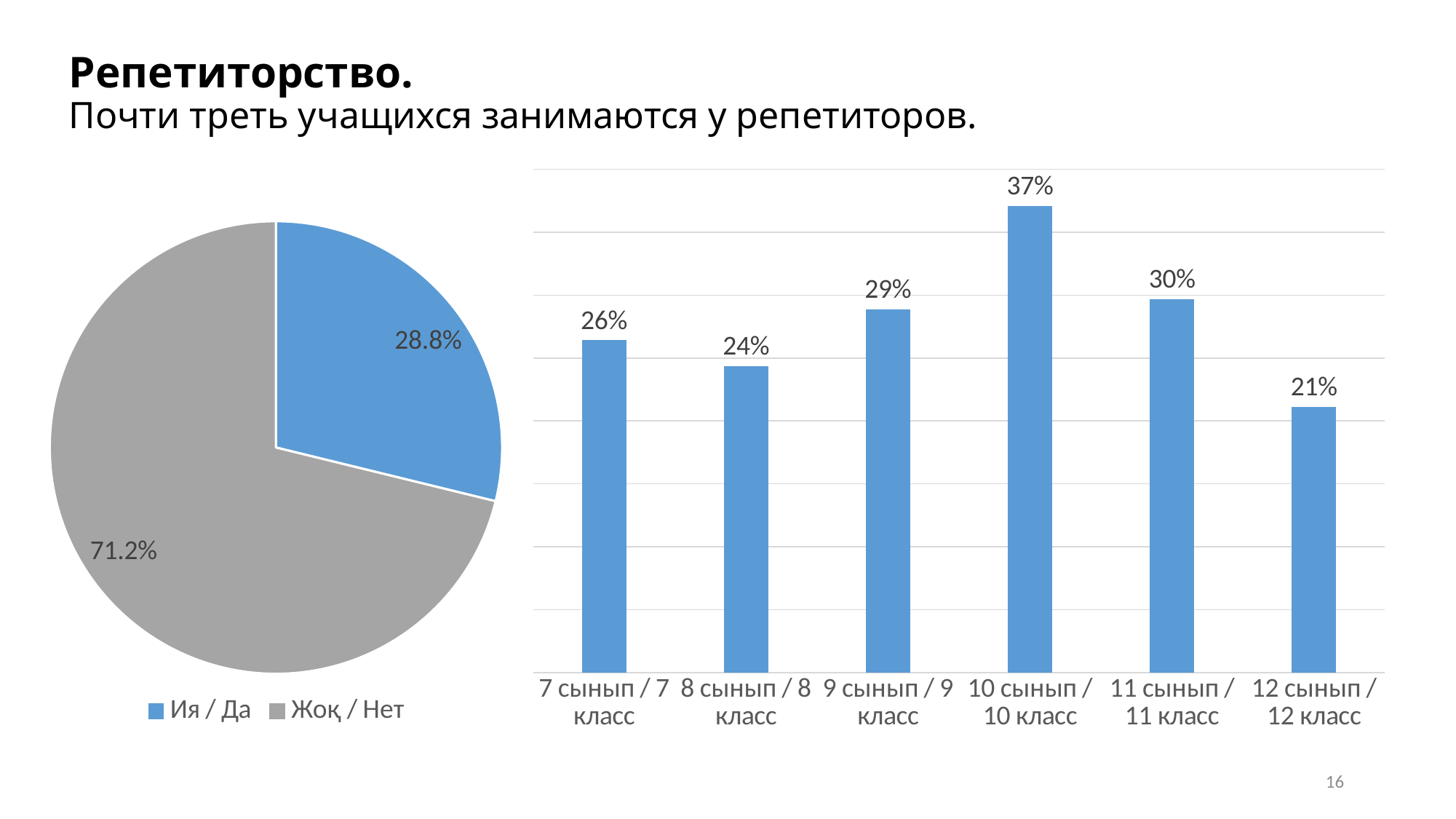
In the bar chart on the right, how many categories are shown on the x axis? 6 In the pie chart on the left, which slice is larger, 'Ия / Да' or 'Жоқ / Нет'? Жоқ / Нет In the pie chart on the left, what share is labelled for the 'Ия / Да' slice? 28.8% In the bar chart on the right, what is the difference between the values for '10 сынып / 10 класс' and '12 сынып / 12 класс'? 16% In the bar chart on the right, which category has the highest value? 10 сынып / 10 класс In the bar chart on the right, which category has the lowest value? 12 сынып / 12 класс In the bar chart on the right, what is the value for '8 сынып / 8 класс'? 24% In the pie chart on the left, what share is labelled for the 'Жоқ / Нет' slice? 71.2% What kind of chart is shown on the right side of the slide? Bar chart In the bar chart on the right, what is the value for '10 сынып / 10 класс'? 37% In the pie chart on the left, how many entries does the legend list? 2 In the bar chart on the right, which is larger, the value for '9 сынып / 9 класс' or '11 сынып / 11 класс'? 11 сынып / 11 класс